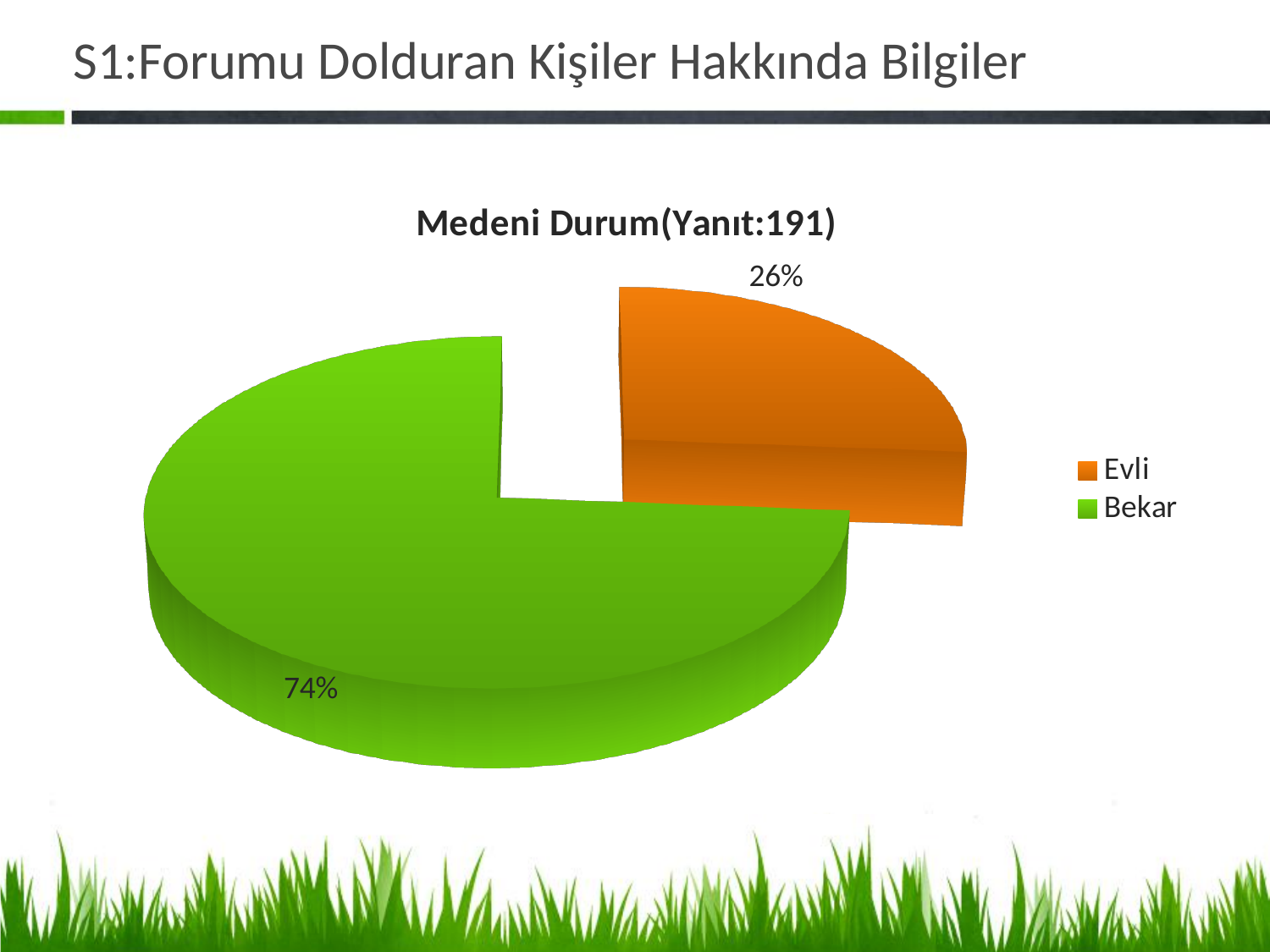
How many categories does the pie chart show? 2 Which category has the smallest share of the pie? Evli What colour is the Evli slice? Orange How many responses (Yanıt) does the chart title state? 191 What percentage of respondents are Bekar (single)? 74% How many entries does the legend list? 2 Which category has the largest share of the pie? Bekar What is the title of the chart? Medeni Durum(Yanıt:191) What kind of chart is shown on the slide? Pie chart What is the difference in percentage points between the Bekar and Evli shares? 48 What percentage of respondents are Evli (married)? 26% Which is larger, the share for Evli or the share for Bekar? Bekar